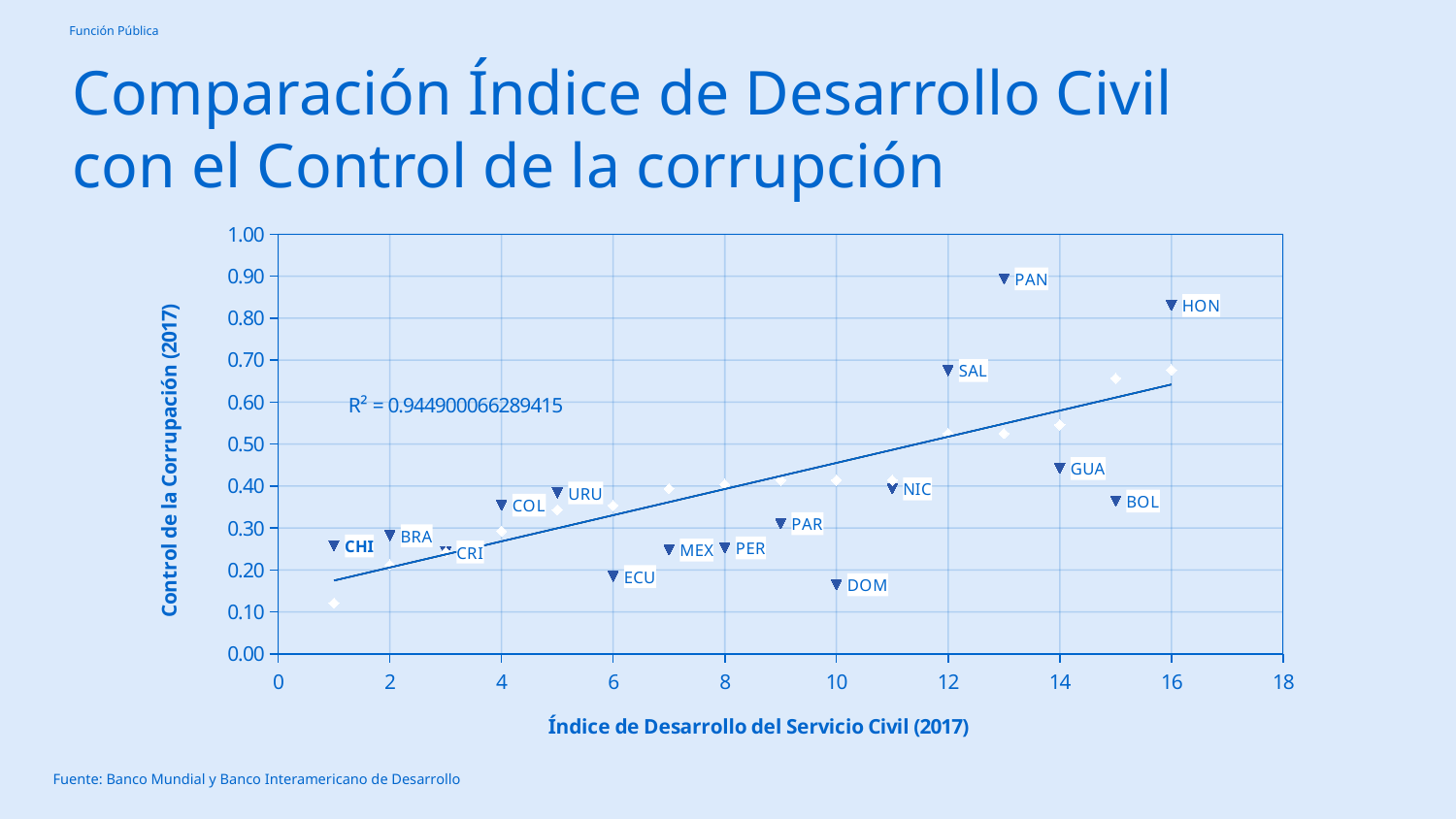
Is the Control de la Corrupción value for CHI greater or less than 0.30? less Is the Control de la Corrupción value for DOM greater or less than 0.20? less What R² value is printed on the chart? R² = 0.944900066289415 Which country has the highest value of Control de la Corrupción (2017)? PAN What is the Índice de Desarrollo del Servicio Civil (2017) value for PAN? 13 Which has a higher Control de la Corrupción value, PAN or HON? PAN Is the Control de la Corrupción value for SAL greater or less than 0.60? greater What kind of chart is shown on the slide? Scatter chart Which has a higher Control de la Corrupción value, SAL or GUA? SAL Does the trend line rise or fall as the Índice de Desarrollo del Servicio Civil increases? rises How many labelled countries are plotted on the chart? 16